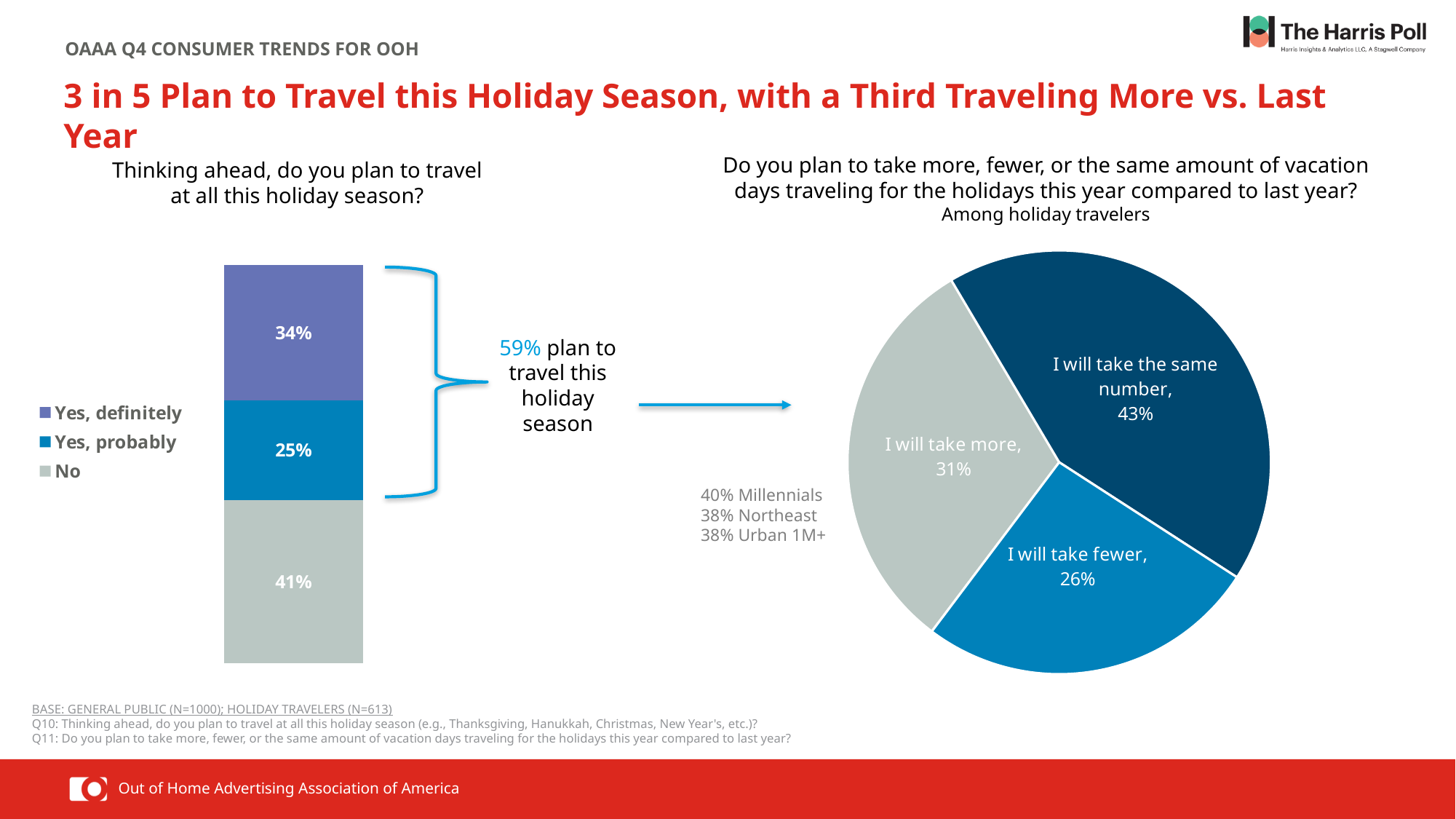
In the stacked bar chart on the left, which response has the largest share? No In the pie chart on the right, what percentage said "I will take fewer"? 26% In the pie chart on the right, which response has the largest slice? I will take the same number What type of chart is shown on the right side of the slide? Pie chart In the stacked bar chart on the left, what is the combined percentage of "Yes, definitely" and "Yes, probably"? 59% In the stacked bar chart on the left, how many response categories does the legend list? 3 In the stacked bar chart on the left, which response has the smallest share? Yes, probably In the stacked bar chart on the left, what percentage answered "No"? 41% In the pie chart on the right, what percentage said "I will take the same number"? 43% In the pie chart on the right, what is the difference between "I will take more" and "I will take fewer"? 5% In the stacked bar chart on the left, what percentage answered "Yes, probably"? 25% In the stacked bar chart on the left, what percentage answered "Yes, definitely"? 34%